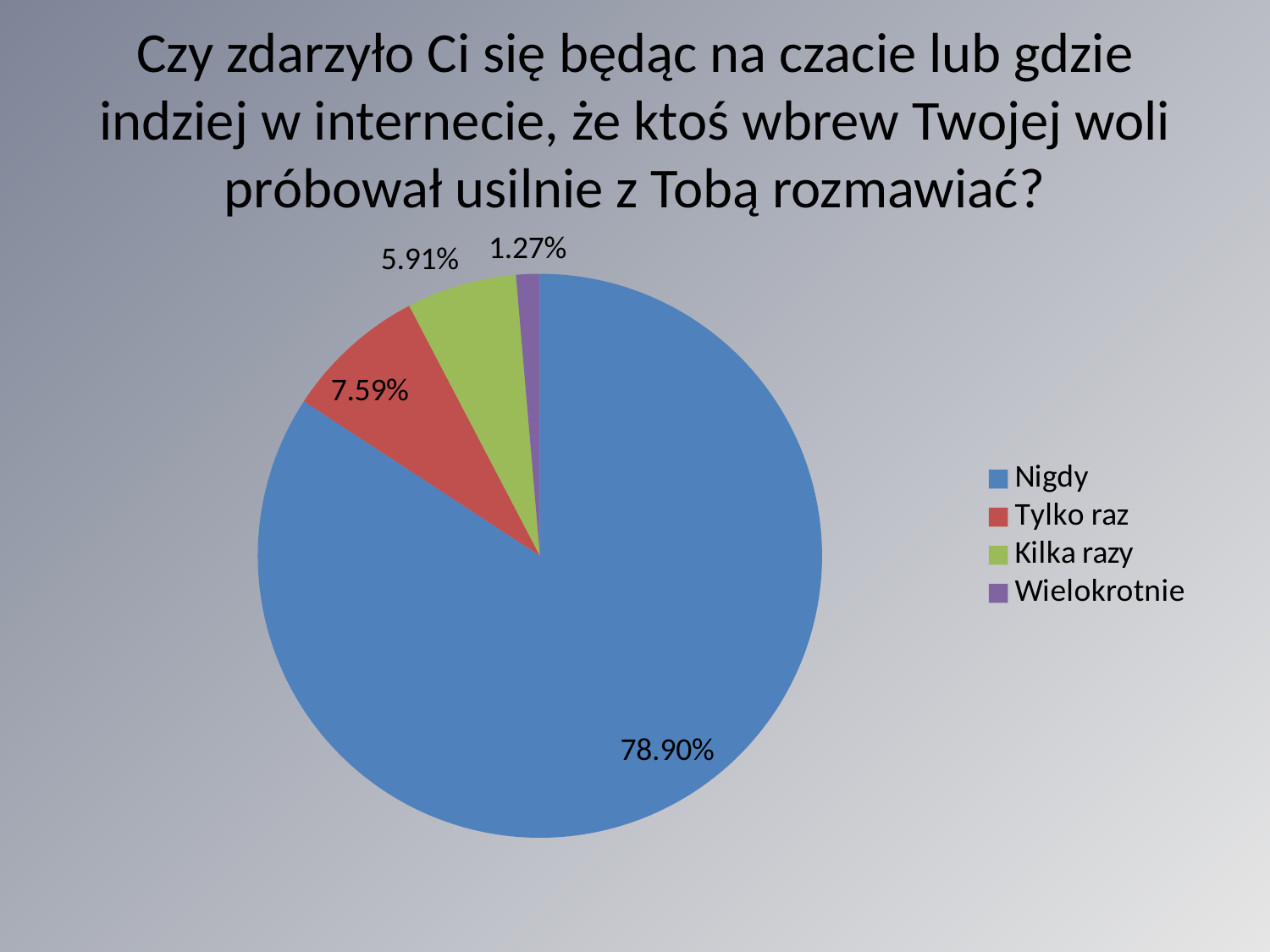
What is the difference between the values for Tylko raz and Kilka razy? 1.68% Which category has the smallest share of the pie? Wielokrotnie Which category has the largest share of the pie? Nigdy What colour is the slice for Kilka razy? green What is the value for Nigdy? 78.90% What is the value for Tylko raz? 7.59% How many categories does the pie chart have? 4 What is the value for Wielokrotnie? 1.27% What kind of chart is shown on the slide? pie chart What is the difference between the values for Nigdy and Tylko raz? 71.31% Which is larger, Tylko raz or Kilka razy? Tylko raz What is the value for Kilka razy? 5.91%